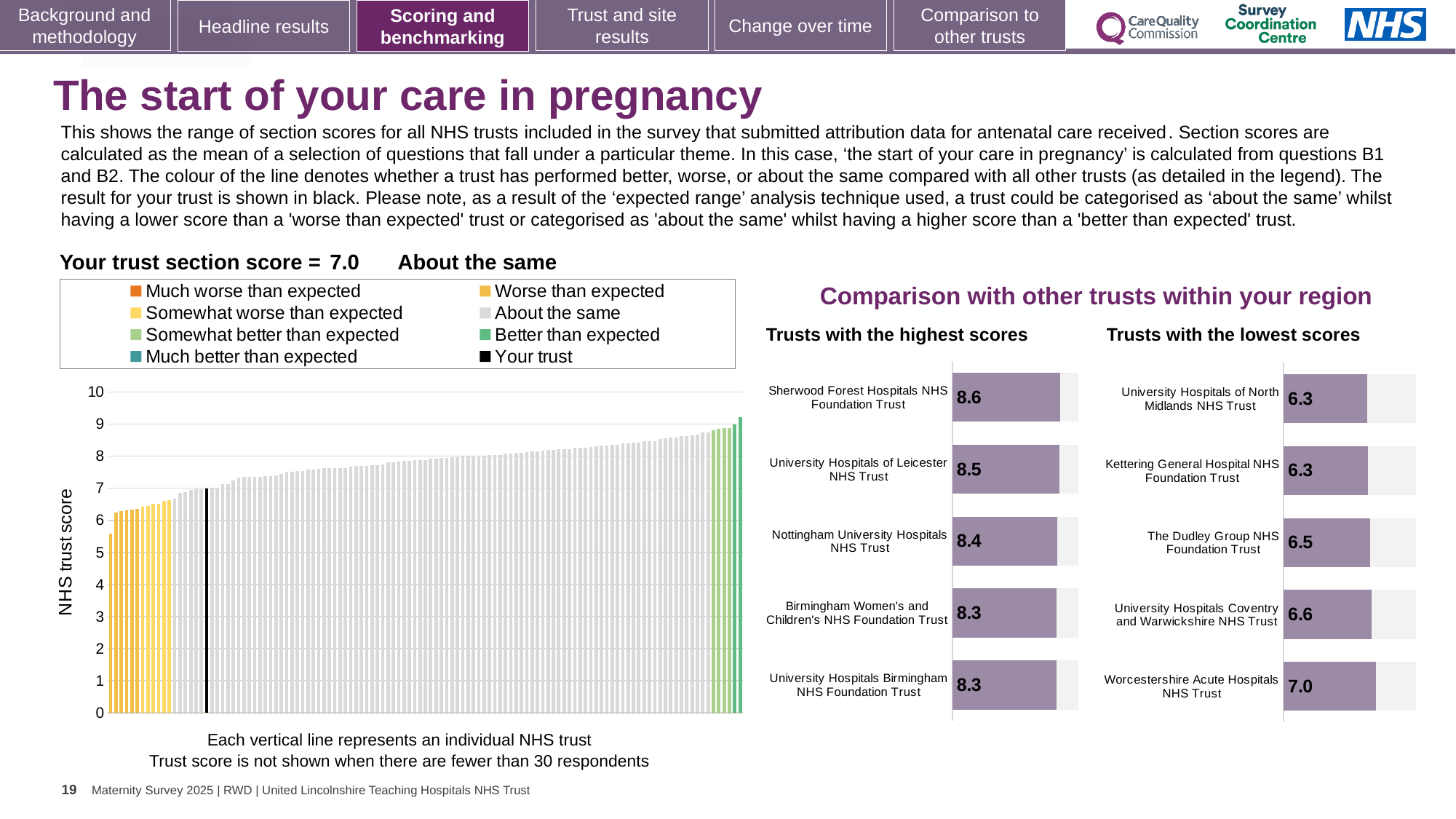
In the 'Trusts with the highest scores' chart, how many trusts are shown? 5 In the 'Trusts with the lowest scores' chart, what is the difference between the scores of Worcestershire Acute Hospitals NHS Trust and University Hospitals Coventry and Warwickshire NHS Trust? 0.4 In the 'Trusts with the highest scores' chart, what is the difference between the scores of Sherwood Forest Hospitals NHS Foundation Trust and University Hospitals Birmingham NHS Foundation Trust? 0.3 In the 'Trusts with the lowest scores' chart, which trust has the highest score? Worcestershire Acute Hospitals NHS Trust What kind of chart is the NHS trust score chart on the left of the slide? bar chart In the 'Trusts with the lowest scores' chart, what is the score for The Dudley Group NHS Foundation Trust? 6.5 In the NHS trust score chart, do the values rise or fall from left to right? rise In the 'Trusts with the highest scores' chart, what is the score for Sherwood Forest Hospitals NHS Foundation Trust? 8.6 In the 'Trusts with the highest scores' chart, which trust has the highest score? Sherwood Forest Hospitals NHS Foundation Trust How many entries does the legend of the NHS trust score chart list? 8 What is your trust's section score shown above the NHS trust score chart? 7.0 In the 'Trusts with the highest scores' chart, which has the larger score: Nottingham University Hospitals NHS Trust or University Hospitals of Leicester NHS Trust? University Hospitals of Leicester NHS Trust